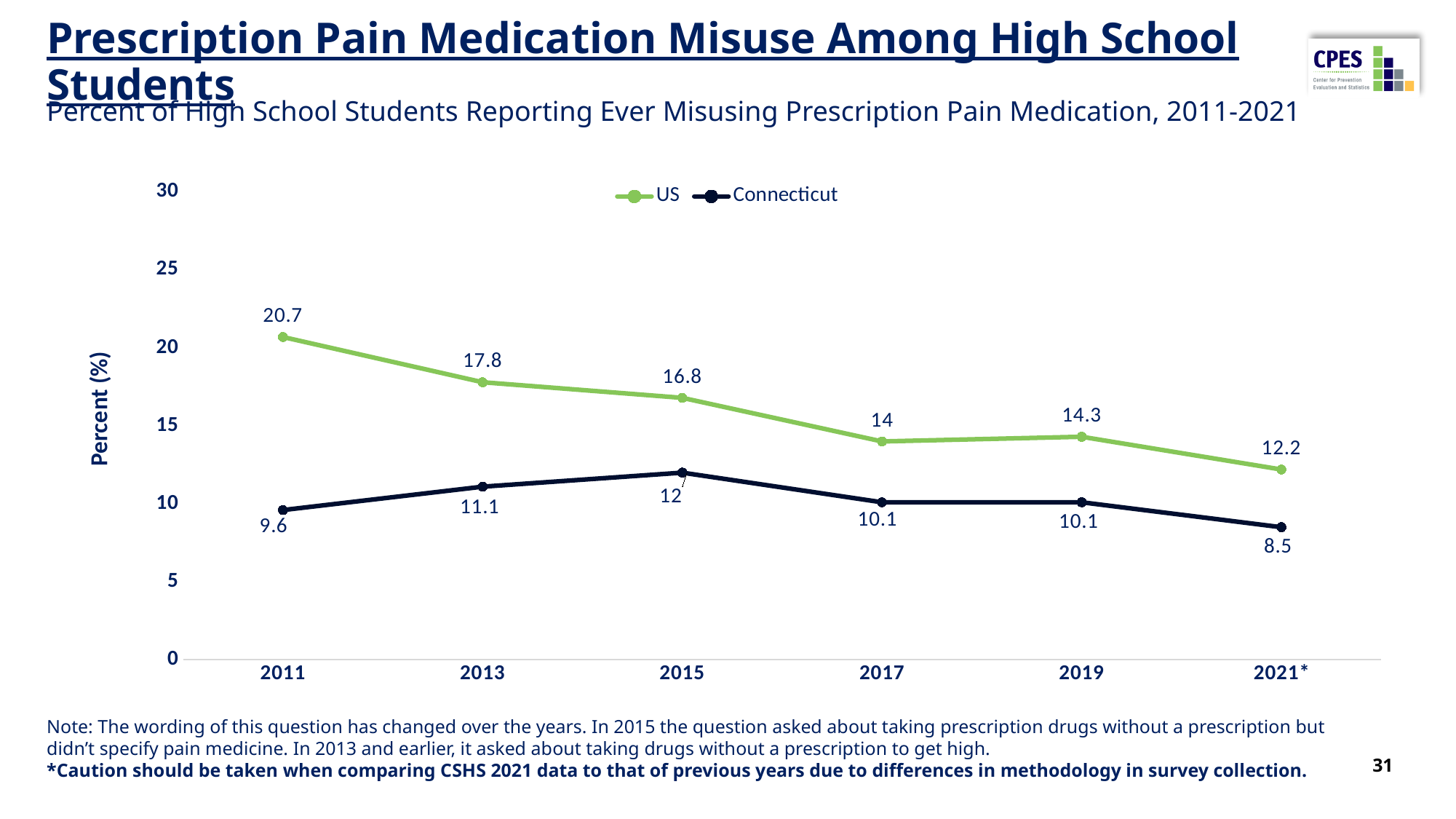
Which was larger in 2019, the US value or the Connecticut value? US Does the US series rise or fall from 2011 to 2021? Fall In which year was the Connecticut value highest? 2015 What is the label on the y axis? Percent (%) In which year was the US value lowest? 2021 What was the US value in 2011? 20.7 How many years are plotted on the x axis? 6 What was the Connecticut value in 2015? 12 How many series does the legend list? 2 What kind of chart is shown on the slide? Line chart What is the difference between the US and Connecticut values in 2011? 11.1 What was the US value in 2021? 12.2